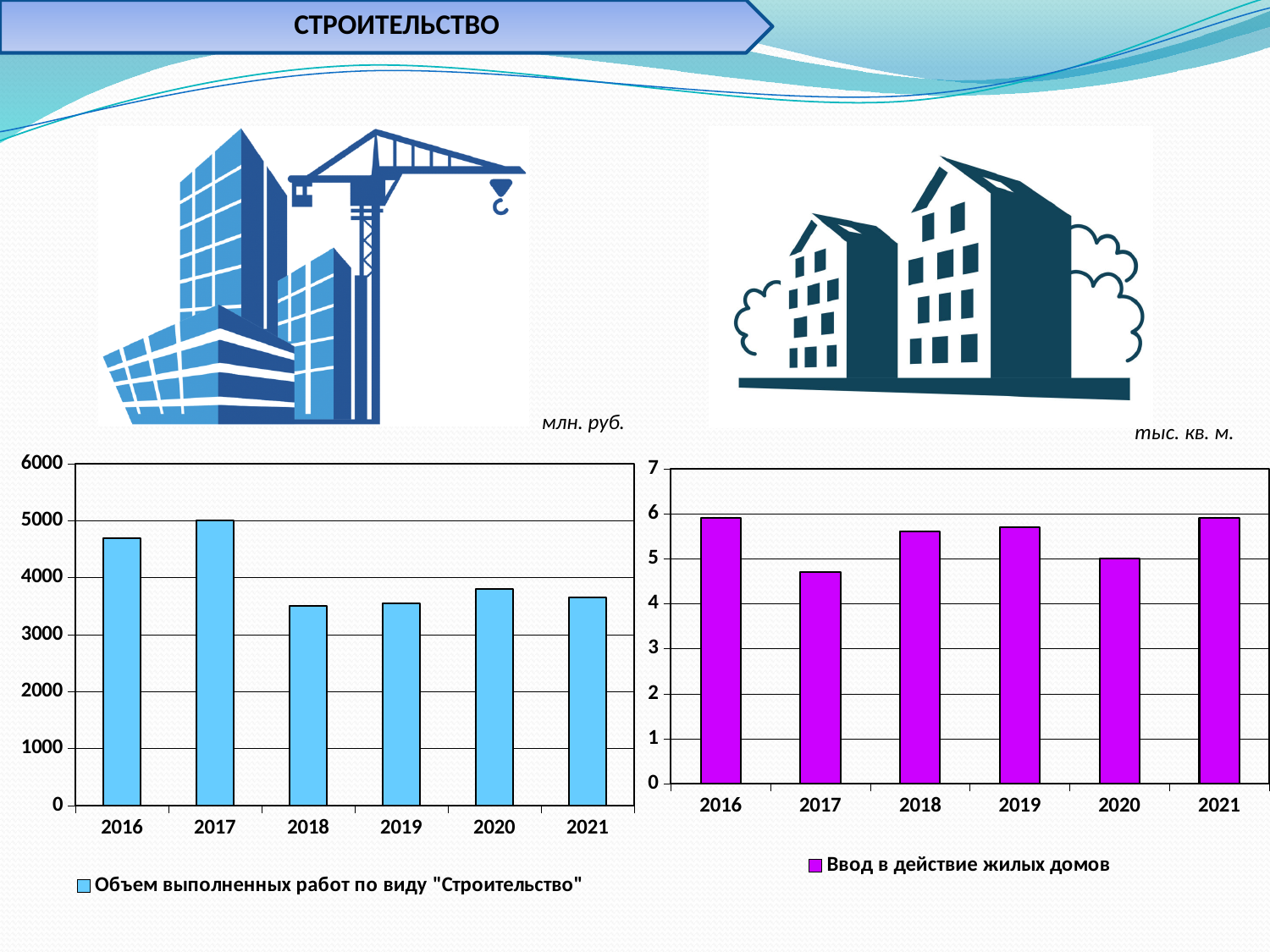
What unit is indicated above the right chart (Ввод в действие жилых домов)? тыс. кв. м. In the right chart (Ввод в действие жилых домов), which is larger, the value for 2018 or the value for 2020? 2018 How many series does the legend of the left chart list? 1 In the left chart (Объем выполненных работ), which is larger, the value for 2016 or the value for 2020? 2016 In the right chart (Ввод в действие жилых домов), is the value for 2017 greater or less than 5? less In the left chart (Объем выполненных работ), is the value for 2016 greater or less than 4000? greater In the right chart (Ввод в действие жилых домов), is the value for 2016 greater or less than 5? greater How many years are shown on the x axis of the right chart (Ввод в действие жилых домов)? 6 In the right chart (Ввод в действие жилых домов), which year has the lowest value? 2017 In the left chart (Объем выполненных работ), which year has the highest value? 2017 What kind of chart is the left chart (Объем выполненных работ по виду "Строительство")? bar chart